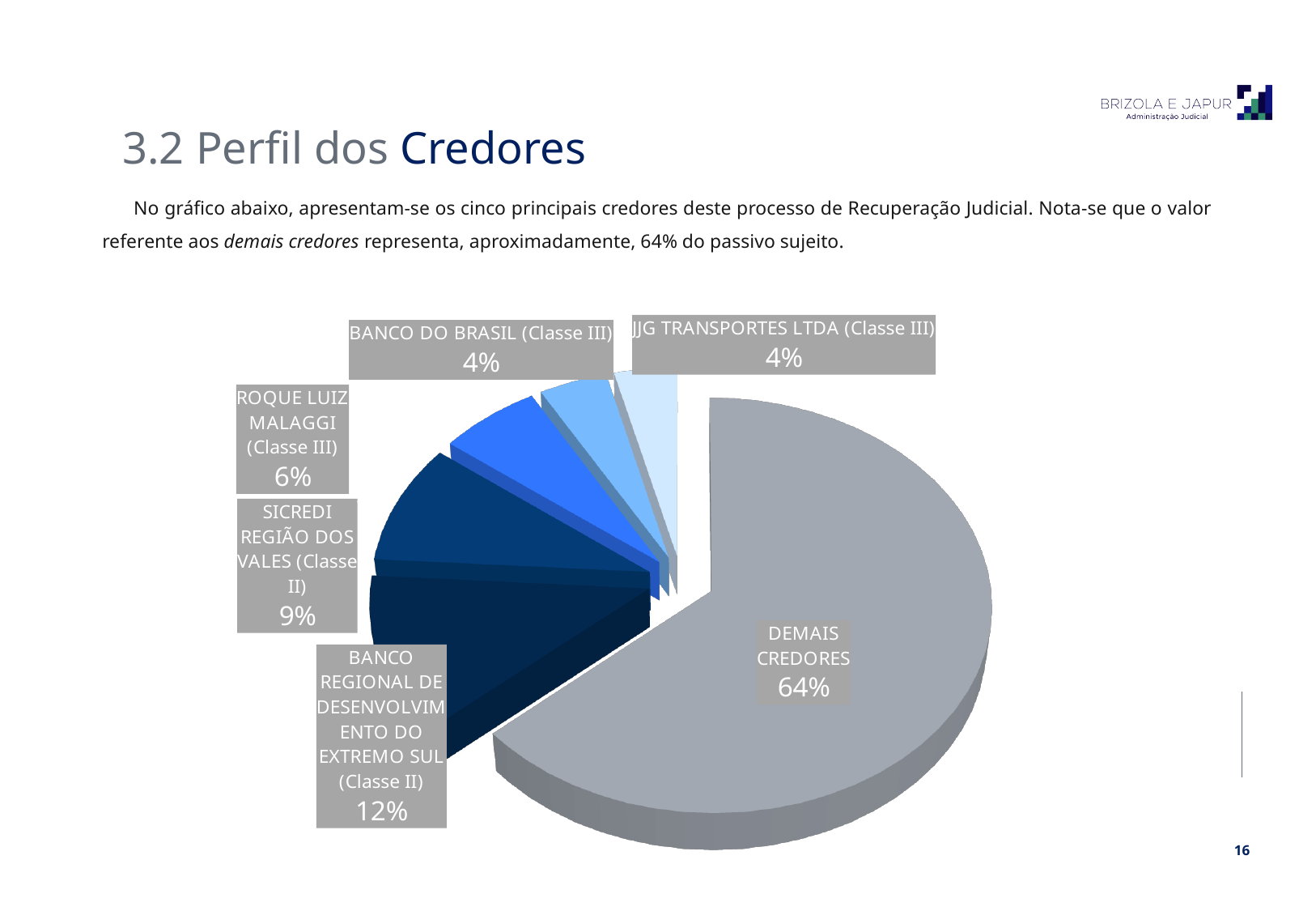
What is the value shown for JJG TRANSPORTES LTDA (Classe III)? 4% What is the value shown for SICREDI REGIÃO DOS VALES (Classe II)? 9% What is the value shown for BANCO REGIONAL DE DESENVOLVIMENTO DO EXTREMO SUL (Classe II)? 12% What is the value shown for ROQUE LUIZ MALAGGI (Classe III)? 6% Which is larger, the share of ROQUE LUIZ MALAGGI (Classe III) or BANCO DO BRASIL (Classe III)? ROQUE LUIZ MALAGGI (Classe III) How many slices does the pie chart have? 6 What is the difference between the share of BANCO REGIONAL DE DESENVOLVIMENTO DO EXTREMO SUL (Classe II) and SICREDI REGIÃO DOS VALES (Classe II)? 3% What kind of chart is shown on the slide? pie chart What is the value shown for BANCO DO BRASIL (Classe III)? 4% Which slice of the pie chart is the largest? DEMAIS CREDORES What is the title of the slide containing the pie chart? 3.2 Perfil dos Credores What share of the pie does DEMAIS CREDORES represent? 64%